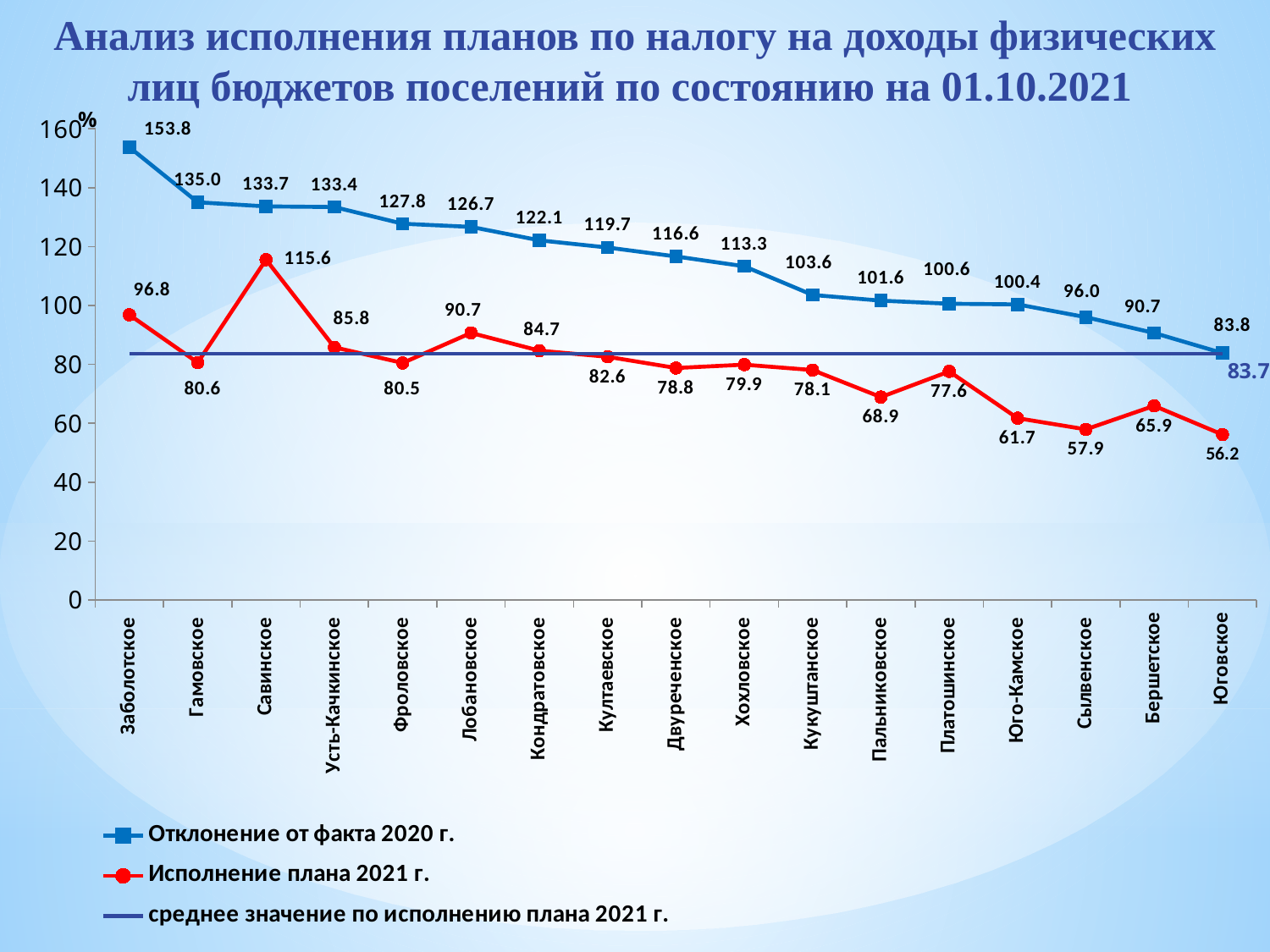
What is the average value of plan execution 2021 (среднее значение по исполнению плана 2021 г.) shown on the chart? 83.7 How many entries does the legend list? 3 What kind of chart is shown on the slide? Line chart What is the difference between "Отклонение от факта 2020 г." and "Исполнение плана 2021 г." for Заболотское? 57.0 Which is larger for Лобановское: "Отклонение от факта 2020 г." or "Исполнение плана 2021 г."? Отклонение от факта 2020 г. Does the "Отклонение от факта 2020 г." series rise or fall from left to right along the x axis? Fall How many settlements are shown on the x axis? 17 Which settlement has the highest value for "Исполнение плана 2021 г."? Савинское What is the value of "Отклонение от факта 2020 г." for Заболотское? 153.8 What is the value of "Исполнение плана 2021 г." for Юговское? 56.2 What is the value of "Исполнение плана 2021 г." for Савинское? 115.6 Which settlement has the lowest value for "Отклонение от факта 2020 г."? Юговское